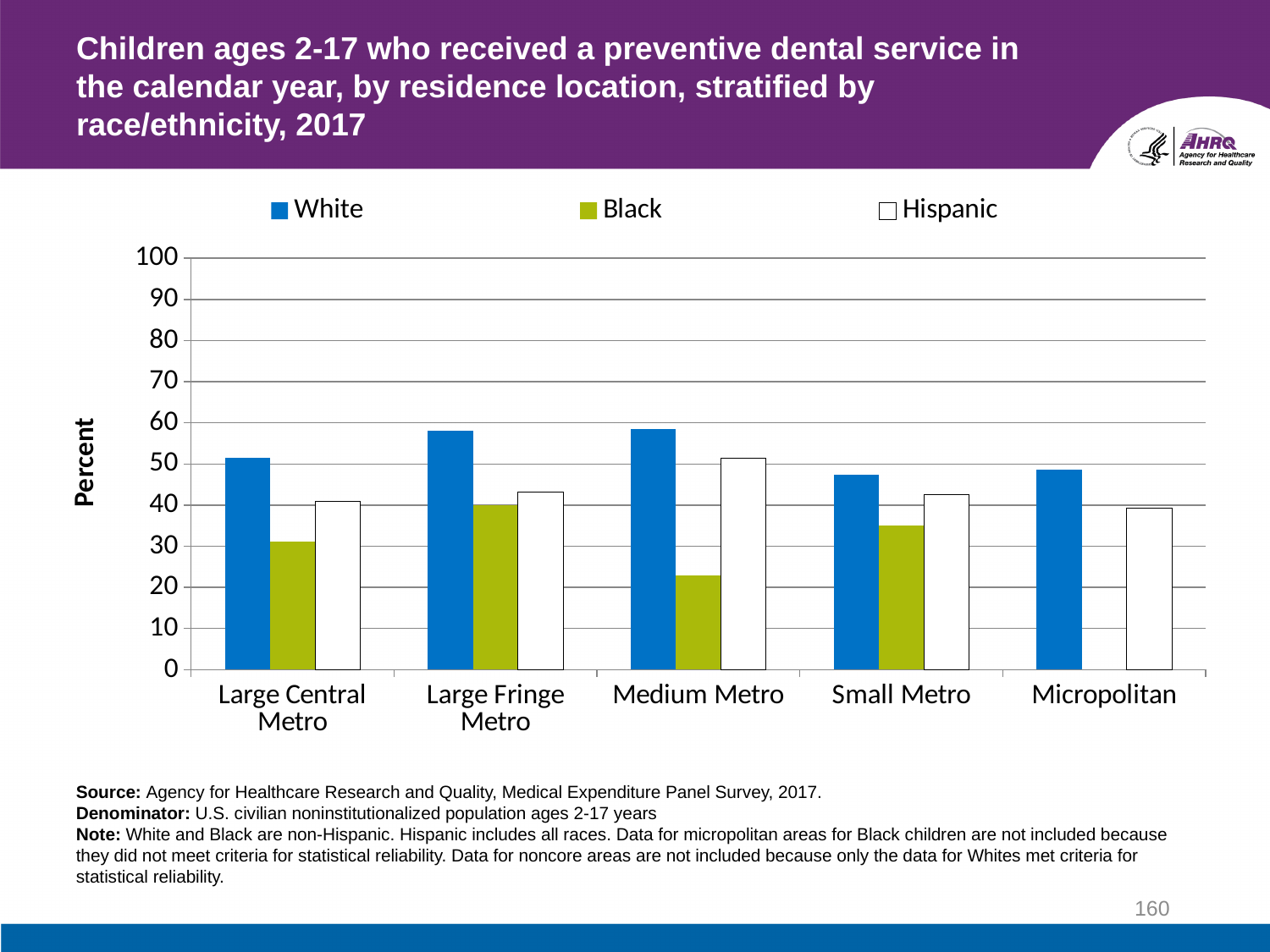
Which residence location has the highest value for Black children? Large Fringe Metro Which residence location has the highest value for Hispanic children? Medium Metro In Medium Metro, which is larger: the value for White children or for Black children? White How many residence location categories are shown on the x axis? 5 In Large Central Metro, which is larger: the value for Hispanic children or for Black children? Hispanic What kind of chart is shown on the slide? bar chart How many series does the legend list? 3 Is the value for Black children in Medium Metro greater or less than 30? less Which residence location has the lowest value for Black children? Medium Metro Is the value for White children in Large Fringe Metro greater or less than 50? greater What is the label on the y axis? Percent Is the value for Black children in Small Metro greater or less than 40? less